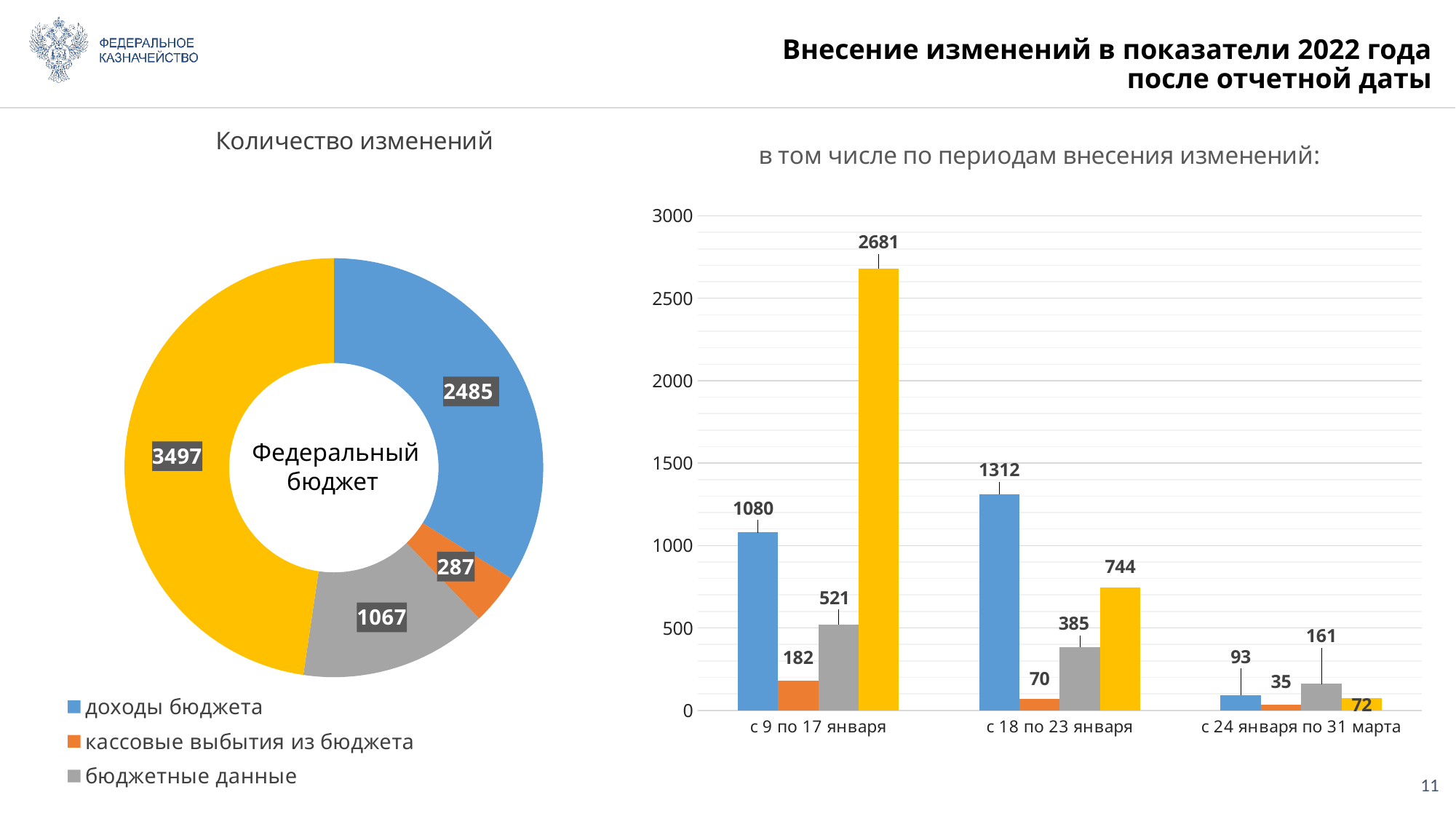
In the doughnut chart "Количество изменений", what is the difference between доходы бюджета and бюджетные данные? 1418 In the doughnut chart "Количество изменений", what is the value for доходы бюджета? 2485 In the bar chart "в том числе по периодам внесения изменений", which period contains the tallest bar? с 9 по 17 января In the bar chart "в том числе по периодам внесения изменений", how many periods are shown on the x axis? 3 In the bar chart "в том числе по периодам внесения изменений", do the orange bars rise or fall from left to right across the periods? fall In the doughnut chart "Количество изменений", which is larger, доходы бюджета or бюджетные данные? доходы бюджета In the bar chart "в том числе по периодам внесения изменений", what is the value of the grey bar for с 18 по 23 января? 385 In the bar chart "в том числе по периодам внесения изменений", what is the difference between the blue bars for с 18 по 23 января and с 9 по 17 января? 232 In the bar chart "в том числе по периодам внесения изменений", what is the value of the blue bar for с 9 по 17 января? 1080 In the doughnut chart "Количество изменений", what is the value for кассовые выбытия из бюджета? 287 How many entries does the legend of the doughnut chart "Количество изменений" list? 3 In the doughnut chart "Количество изменений", what is the value for бюджетные данные? 1067